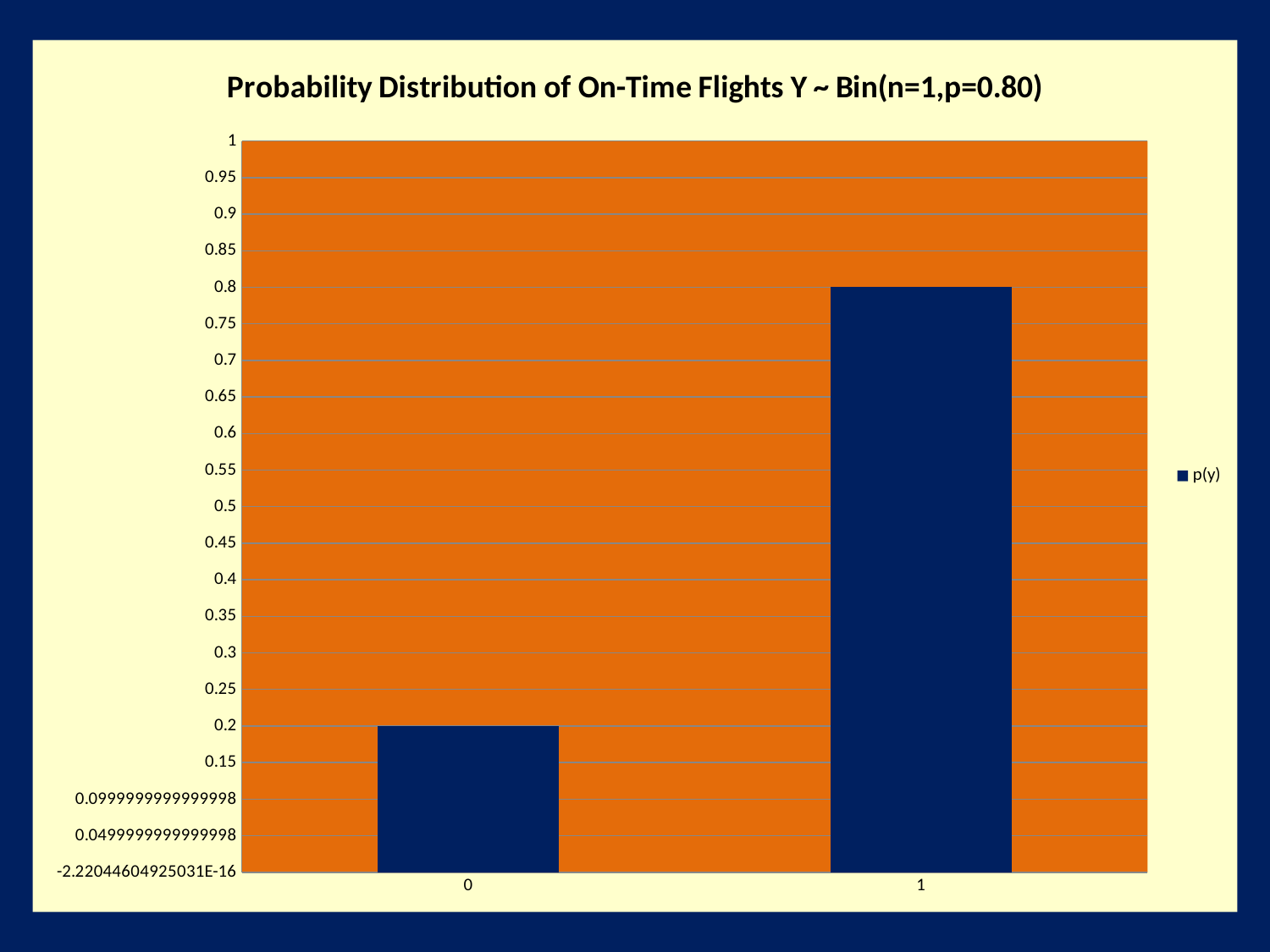
What is the value of p(y) for category 0? 0.2 Which category has the lowest value of p(y)? 0 What is the value of p(y) for category 1? 0.8 How many series does the legend list? 1 Which category has the highest value of p(y)? 1 Is the value for category 1 greater or less than 0.5? greater Is the value for category 0 greater or less than 0.5? less How many categories are shown on the x axis? 2 Which has a larger p(y) value, category 0 or category 1? 1 What is the difference between the p(y) values for category 1 and category 0? 0.6 What is the title of the chart? Probability Distribution of On-Time Flights Y ~ Bin(n=1,p=0.80) What kind of chart is shown on the slide? bar chart